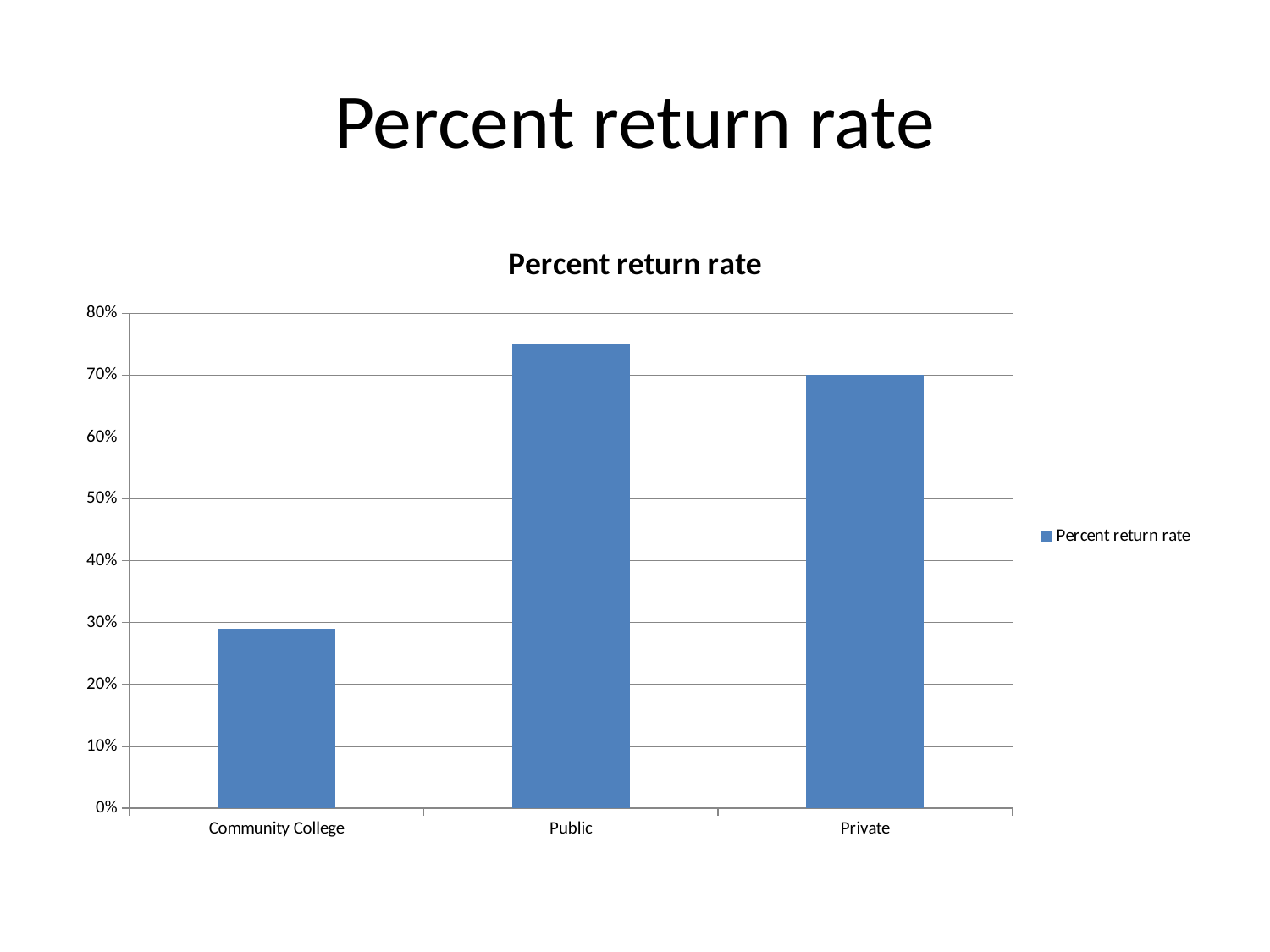
What is the title of the chart? Percent return rate How many series does the legend list? 1 Is the value for Public greater or less than 80%? less Which category has the highest percent return rate? Public Is the value for Public greater or less than 70%? greater Which category has the lowest percent return rate? Community College Which has a higher percent return rate, Community College or Private? Private What type of chart is shown on the slide? Bar chart What is the name of the series listed in the legend? Percent return rate How many categories are shown on the x axis of the chart? 3 Is the value for Community College greater or less than 40%? less Which has a higher percent return rate, Public or Private? Public